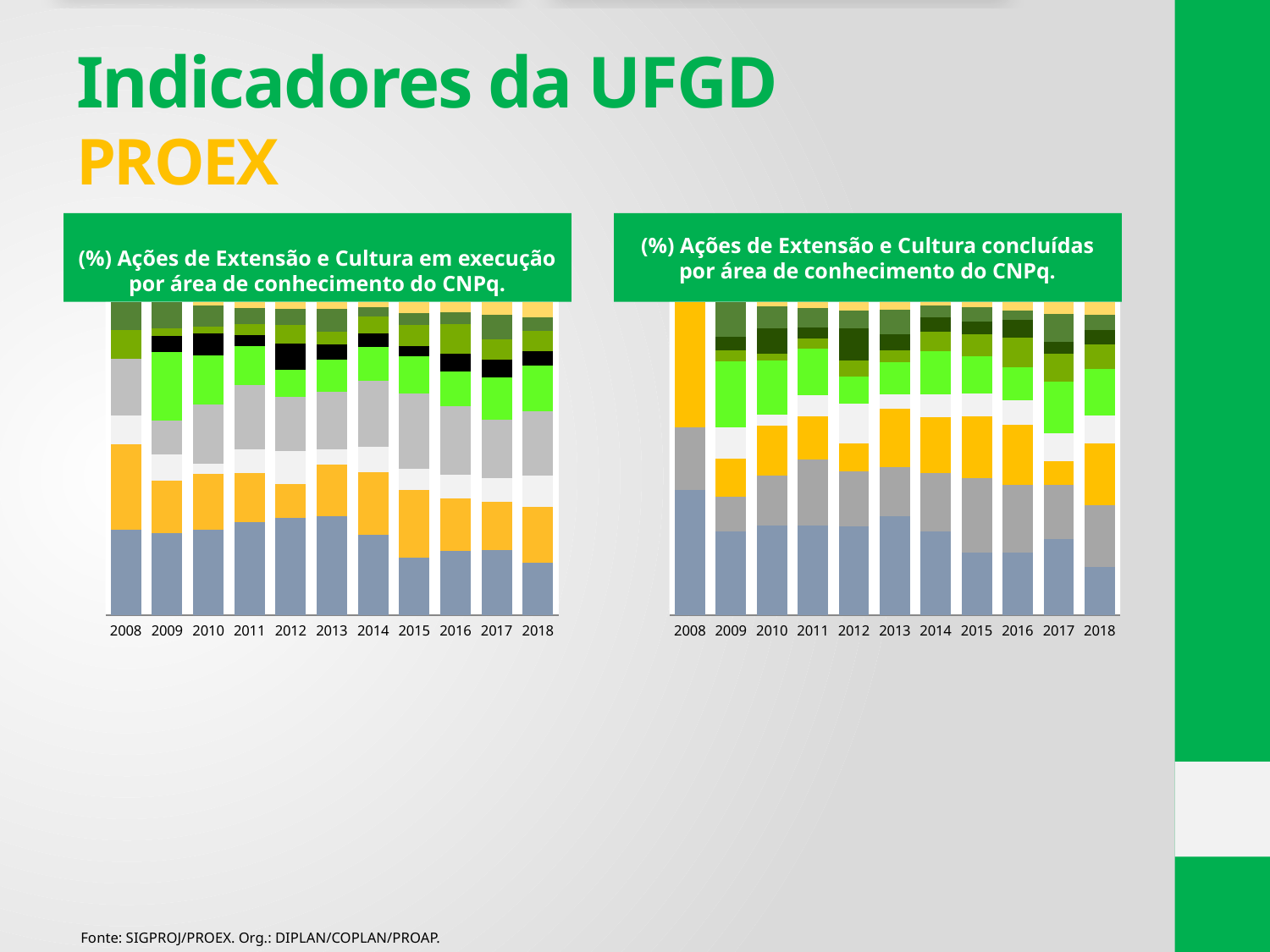
In the right chart, '(%) Ações de Extensão e Cultura concluídas por área de conhecimento do CNPq.', how many years are shown on the x axis? 11 In the right chart, '(%) Ações de Extensão e Cultura concluídas por área de conhecimento do CNPq.', how many coloured segments does the 2008 bar contain? 3 What is the title of the right chart on the slide? (%) Ações de Extensão e Cultura concluídas por área de conhecimento do CNPq. What is the first year shown on the x axis of the left chart, '(%) Ações de Extensão e Cultura em execução por área de conhecimento do CNPq.'? 2008 In the right chart, '(%) Ações de Extensão e Cultura concluídas por área de conhecimento do CNPq.', which year has the largest bottom (blue-grey) segment? 2008 In the left chart, '(%) Ações de Extensão e Cultura em execução por área de conhecimento do CNPq.', how many years are shown on the x axis? 11 In the right chart, '(%) Ações de Extensão e Cultura concluídas por área de conhecimento do CNPq.', which year has the smallest bottom (blue-grey) segment? 2018 In the right chart, '(%) Ações de Extensão e Cultura concluídas por área de conhecimento do CNPq.', does the bottom (blue-grey) segment generally rise or fall from 2008 to 2018? Fall What kind of chart is the right chart, '(%) Ações de Extensão e Cultura concluídas por área de conhecimento do CNPq.'? Stacked bar chart What kind of chart is the left chart, '(%) Ações de Extensão e Cultura em execução por área de conhecimento do CNPq.'? Stacked bar chart In the right chart, '(%) Ações de Extensão e Cultura concluídas por área de conhecimento do CNPq.', is the bottom (blue-grey) segment larger in 2008 or in 2018? 2008